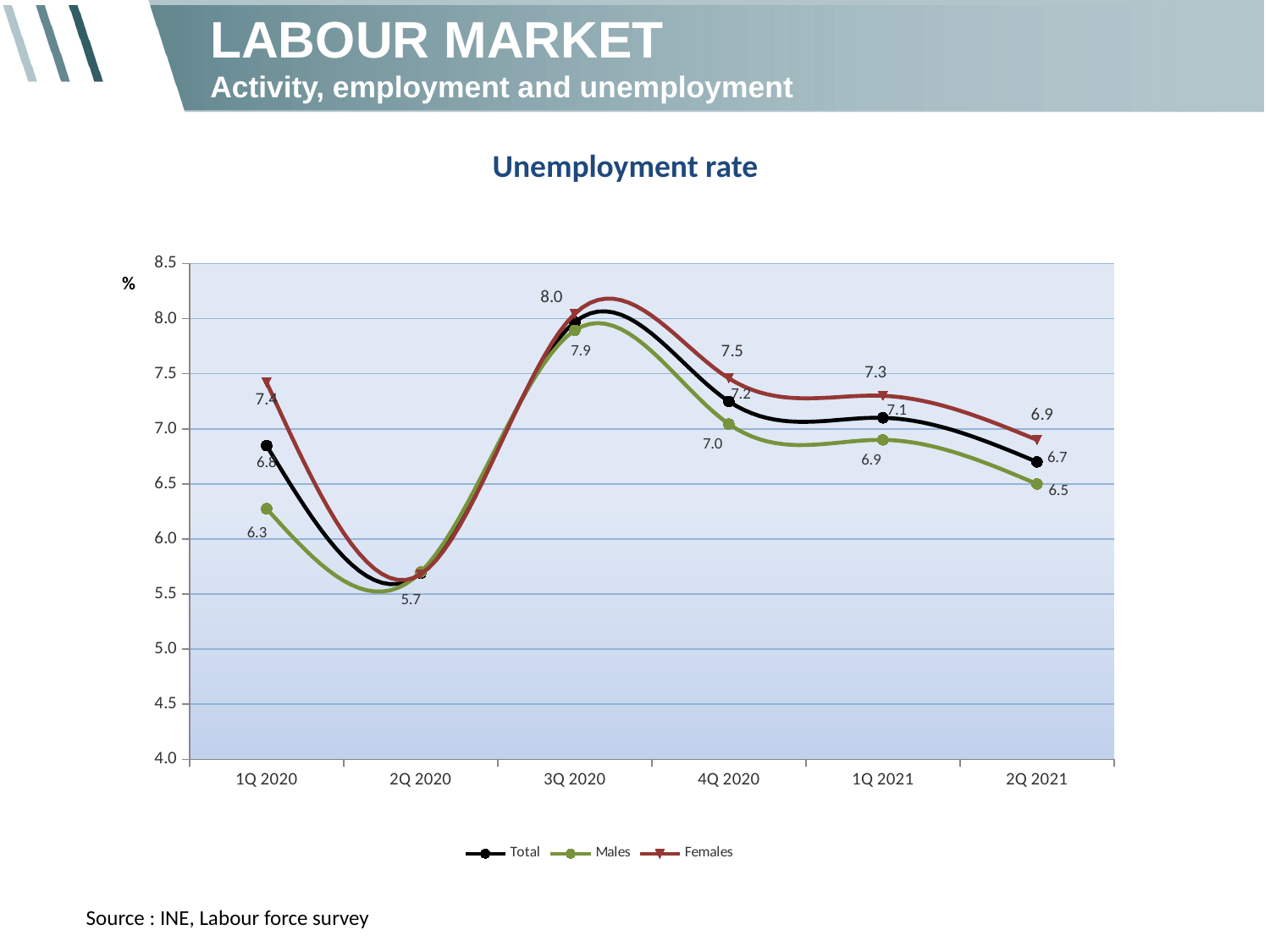
In which quarter is the Males unemployment rate lowest? 2Q 2020 What is the unemployment rate for Females in 4Q 2020? 7.5 Which is larger in 1Q 2021, the Females or the Males unemployment rate? Females Does the Total unemployment rate rise or fall from 4Q 2020 to 2Q 2021? Fall What is the Total unemployment rate in 1Q 2021? 7.1 What is the unemployment rate for Males in 2Q 2021? 6.5 In which quarter is the Females unemployment rate highest? 3Q 2020 How many quarters are plotted along the x axis of the Unemployment rate chart? 6 What is the difference between the Females and Males unemployment rates in 4Q 2020? 0.5 How many series does the legend of the Unemployment rate chart list? 3 Is the Males unemployment rate in 2Q 2020 greater or less than 6.0? less What kind of chart is shown on the slide? Line chart